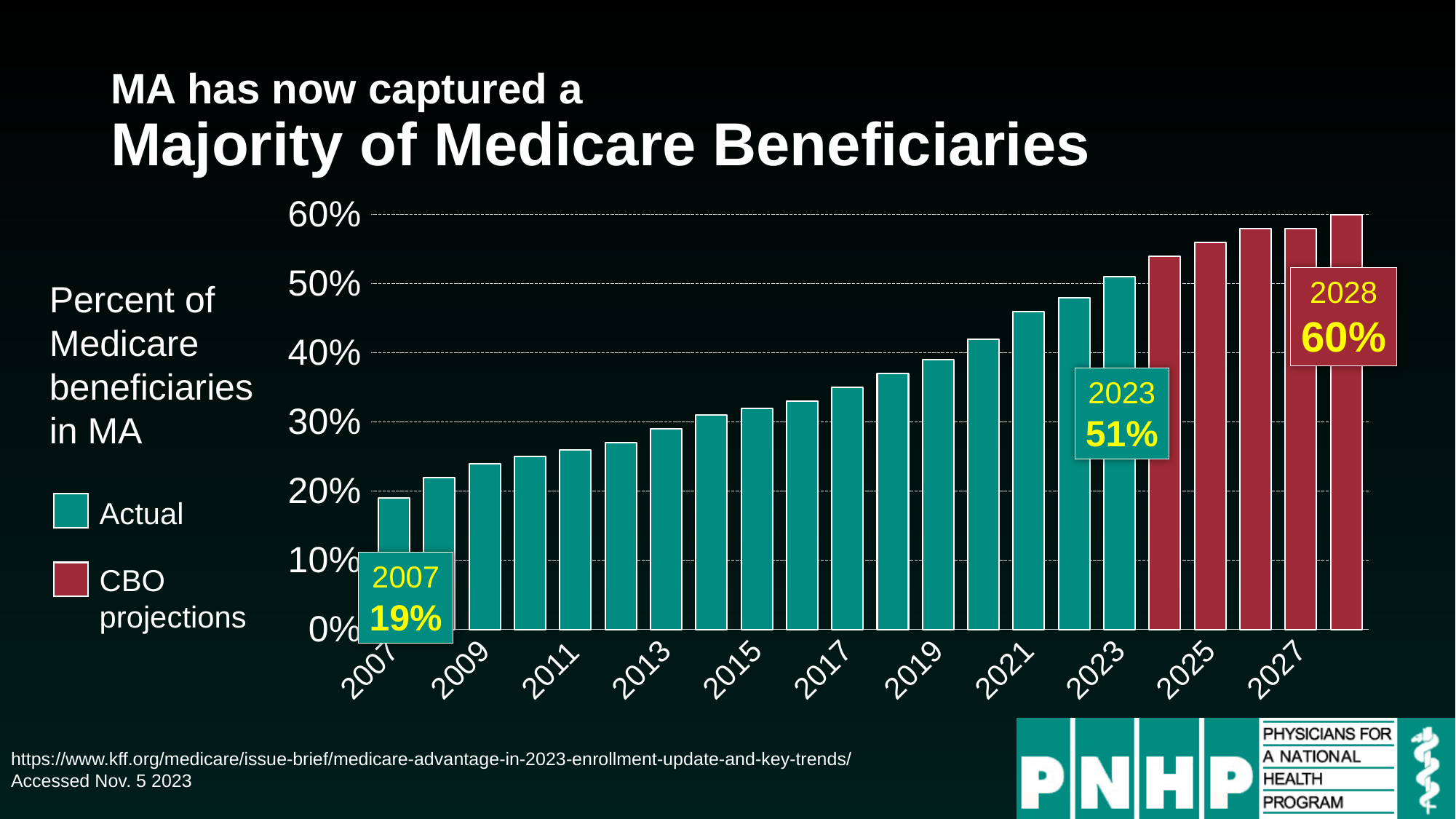
By how many percentage points did the share of Medicare beneficiaries in MA increase from 2007 to 2023? 32 percentage points Which year has the lowest bar on the chart? 2007 Which is larger, the value for 2023 or the projected value for 2028? 2028 Is the value for 2021 greater or less than 40%? greater Which year has the highest bar on the chart? 2028 What kind of chart is shown on the slide? Bar chart What percent of Medicare beneficiaries were in MA in 2023? 51% What percent of Medicare beneficiaries were in MA in 2007? 19% Is the value for 2019 greater or less than 40%? less How many series does the legend list? 2 Do the values rise or fall from 2007 to 2028? Rise What is the CBO projected percent of Medicare beneficiaries in MA for 2028? 60%